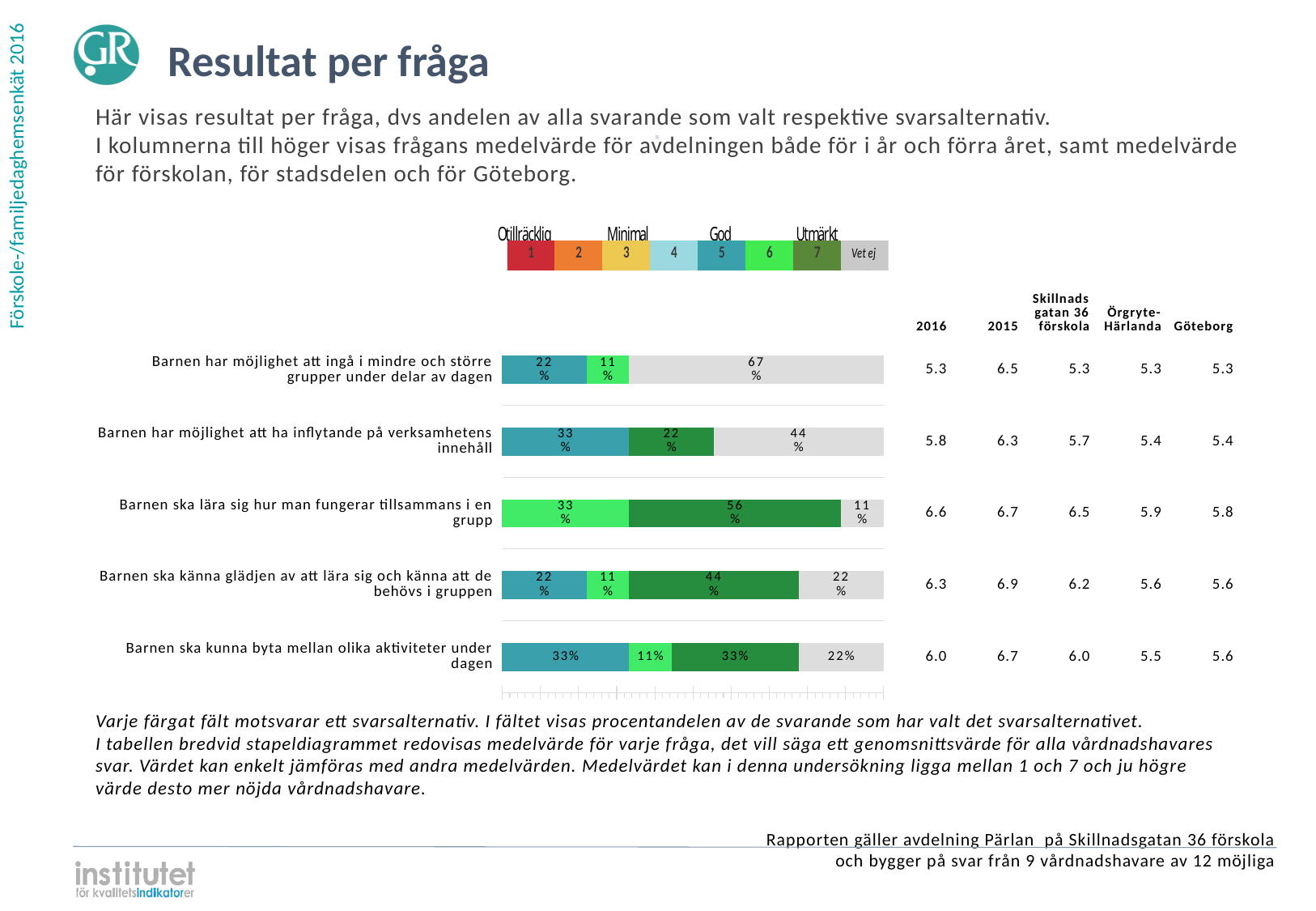
What percentage of respondents answered 'Vet ej' for 'Barnen har möjlighet att ingå i mindre och större grupper under delar av dagen'? 67% What is the 2016 mean value for 'Barnen ska lära sig hur man fungerar tillsammans i en grupp'? 6.6 For 'Barnen ska kunna byta mellan olika aktiviteter under dagen', which is larger: the share for option 5 (teal) or the share for option 6 (bright green)? Option 5 (33%) How many questions (categories) are shown in the bar chart? 5 What is the difference in percentage points between the 'Vet ej' share for 'Barnen har möjlighet att ingå i mindre och större grupper under delar av dagen' (67%) and for 'Barnen ska lära sig hur man fungerar tillsammans i en grupp' (11%)? 56 percentage points What percentage chose answer option 5 (teal) for 'Barnen har möjlighet att ha inflytande på verksamhetens innehåll'? 33% What percentage chose answer option 7 (dark green) for 'Barnen ska lära sig hur man fungerar tillsammans i en grupp'? 56% What kind of chart is used to show the share of respondents per answer option? Stacked bar chart Which question has the smallest 'Vet ej' share? Barnen ska lära sig hur man fungerar tillsammans i en grupp What label does the legend give to answer options 1 and 2? Otillräcklig What is the 2015 mean value for 'Barnen ska känna glädjen av att lära sig och känna att de behövs i gruppen'? 6.9 Which question has the largest 'Vet ej' share? Barnen har möjlighet att ingå i mindre och större grupper under delar av dagen